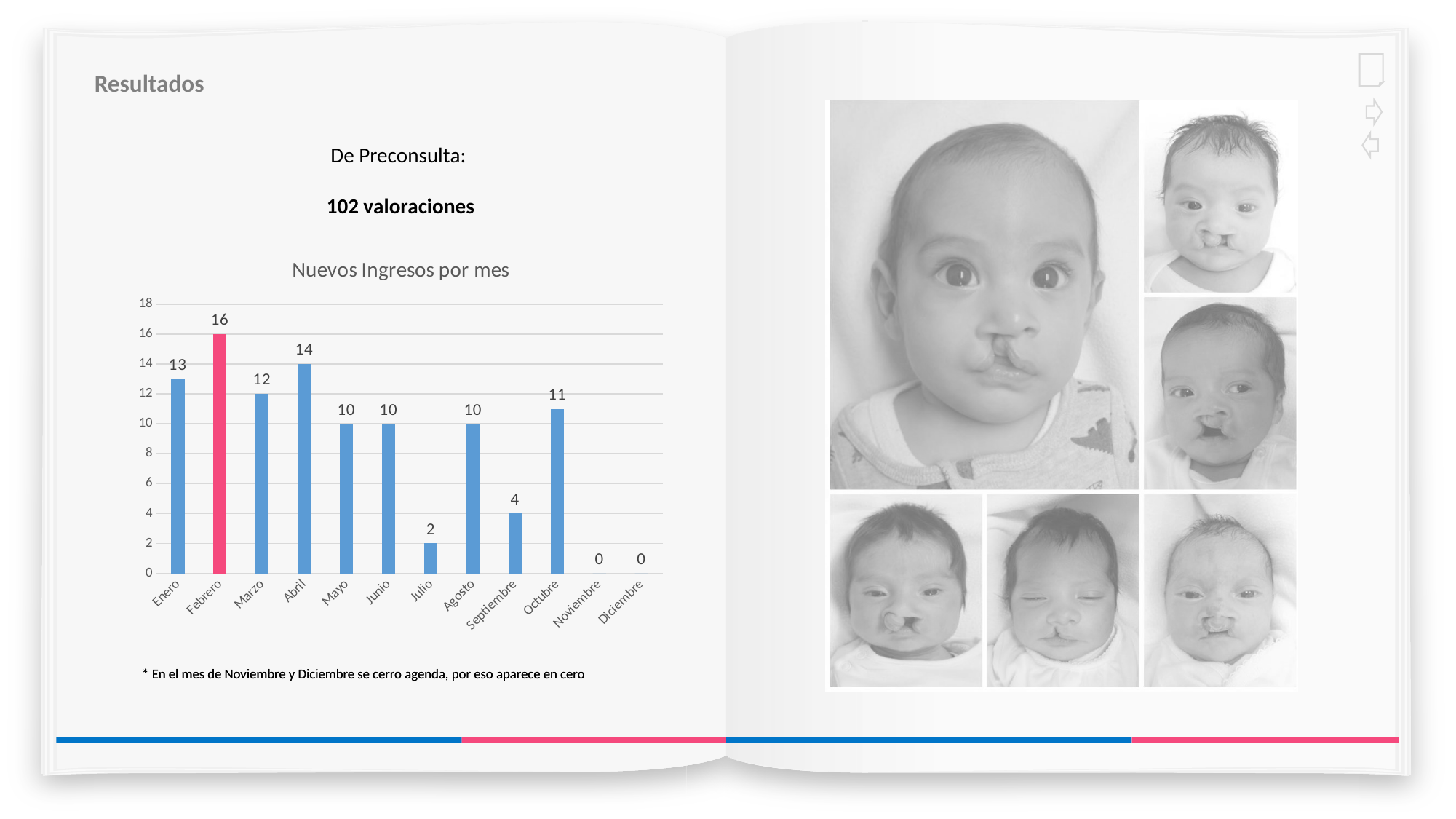
What kind of chart is 'Nuevos Ingresos por mes'? Bar chart What is the difference between the values for Abril and Marzo in the 'Nuevos Ingresos por mes' chart? 2 What is the value for Febrero in the 'Nuevos Ingresos por mes' chart? 16 What is the value for Julio in the 'Nuevos Ingresos por mes' chart? 2 Which bar in the 'Nuevos Ingresos por mes' chart is coloured pink instead of blue? Febrero What is the value for Octubre in the 'Nuevos Ingresos por mes' chart? 11 How many months are shown on the x axis of the 'Nuevos Ingresos por mes' chart? 12 Which month has the highest value in the 'Nuevos Ingresos por mes' chart? Febrero What is the title of the chart on the slide? Nuevos Ingresos por mes Which is larger in the 'Nuevos Ingresos por mes' chart, the value for Enero or the value for Septiembre? Enero What is the value for Noviembre in the 'Nuevos Ingresos por mes' chart? 0 How many months in the 'Nuevos Ingresos por mes' chart have a value of 10? 3